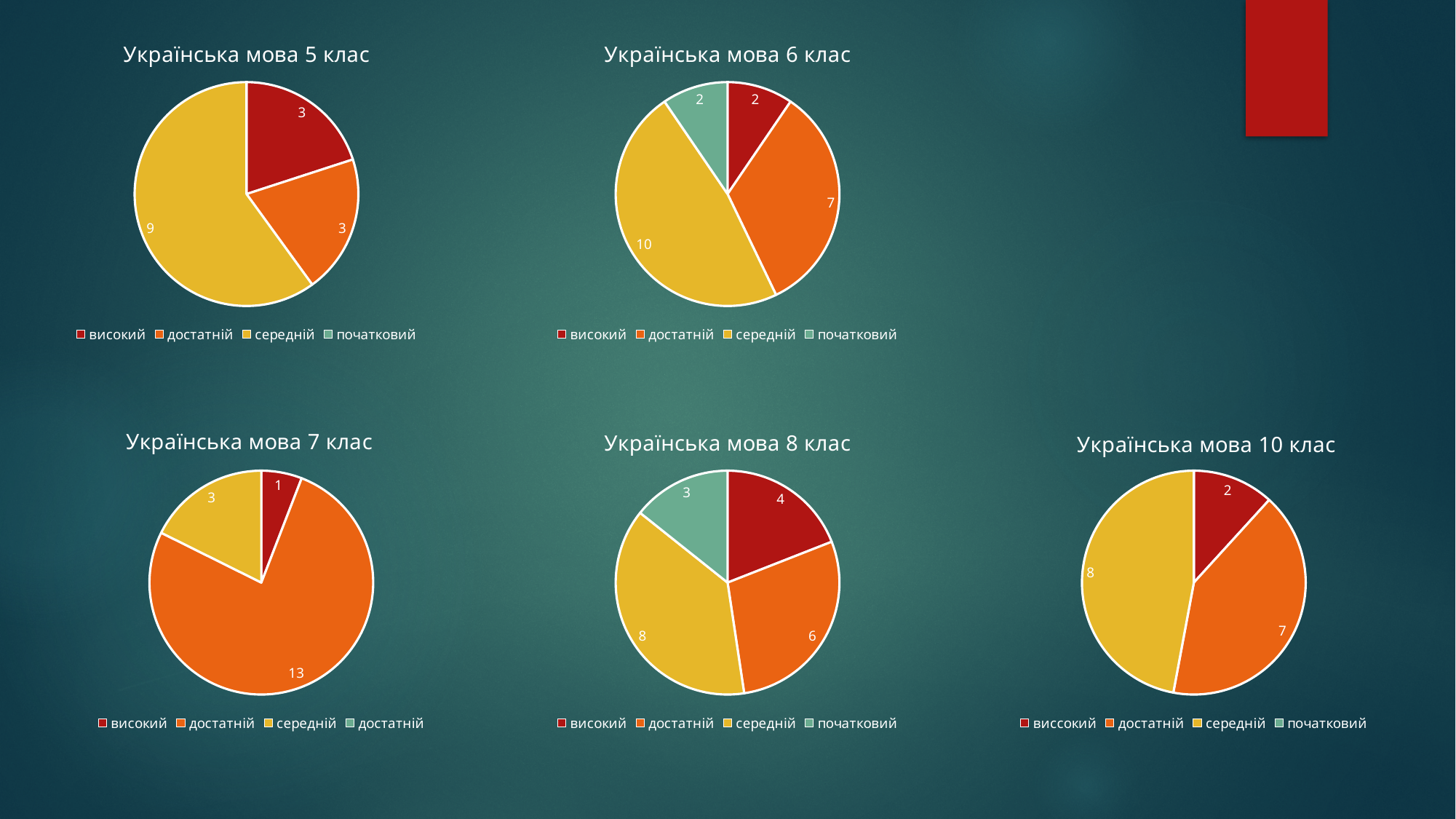
In the chart titled 'Українська мова 7 клас', which category has the largest slice? достатній What kind of chart is the chart titled 'Українська мова 7 клас'? pie chart In the chart titled 'Українська мова 5 клас', what share of the pie does середній represent? 60% In the chart titled 'Українська мова 8 клас', which is larger, the value for середній or the value for достатній? середній In the chart titled 'Українська мова 10 клас', what is the difference between the values for середній and високий? 6 How many pie charts are shown on the slide? 5 How many entries does the legend of the chart titled 'Українська мова 8 клас' list? 4 In the chart titled 'Українська мова 5 клас', what is the value for середній? 9 In the chart titled 'Українська мова 8 клас', which category has the smallest slice? початковий In the chart titled 'Українська мова 6 клас', how many slices does the pie have? 4 In the chart titled 'Українська мова 6 клас', what is the value for початковий? 2 In the chart titled 'Українська мова 6 клас', what is the value for достатній? 7